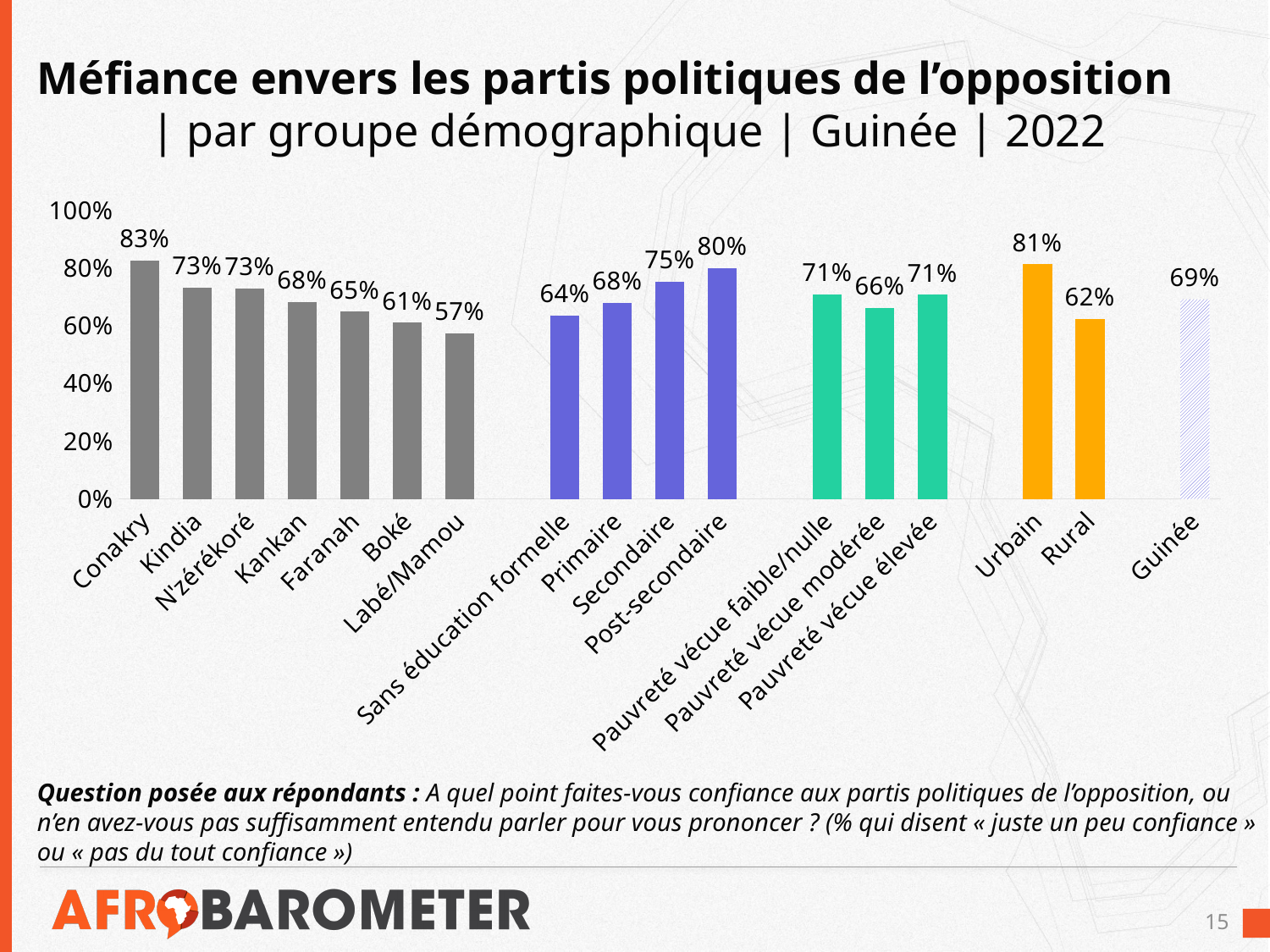
What is the difference between the values for Post-secondaire and Sans éducation formelle? 16 percentage points Which category has the highest value on the chart? Conakry What is the value for Post-secondaire? 80% What is the value for Guinée overall? 69% How many categories are plotted on the chart? 17 Which is larger, the value for Kankan or the value for Faranah? Kankan What is the difference between the values for Urbain and Rural? 19 percentage points Do the values rise or fall across the education categories from Sans éducation formelle to Post-secondaire? Rise What is the value for Conakry? 83% Which category has the lowest value on the chart? Labé/Mamou What is the value for Rural? 62% What kind of chart is shown on the slide? Bar chart